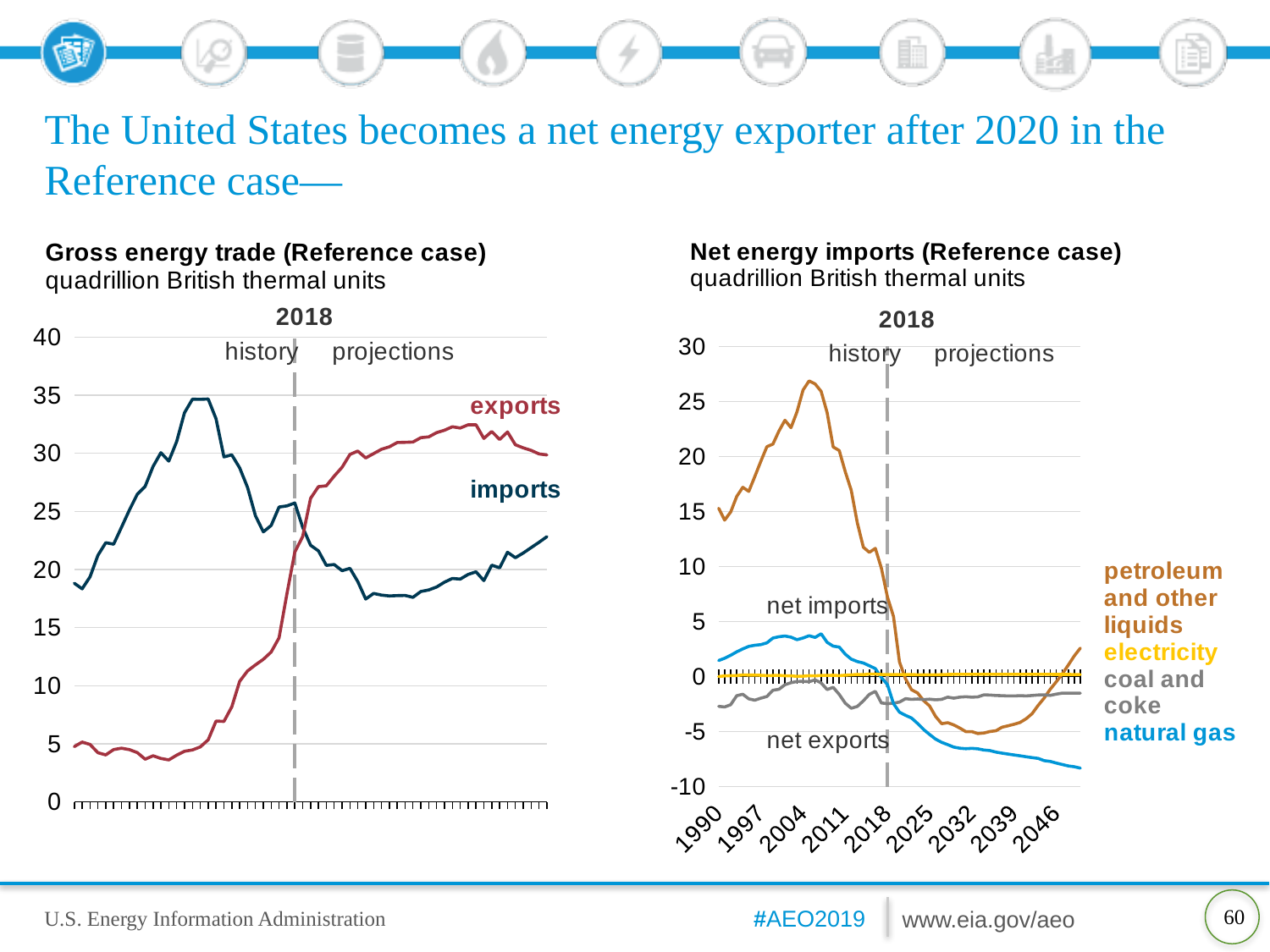
In the 'Gross energy trade (Reference case)' chart, which is larger at the end of the projection period, exports or imports? exports In the 'Net energy imports (Reference case)' chart, is the value for natural gas at the end of the projection period greater or less than -5? less How many series are listed in the legend of the 'Net energy imports (Reference case)' chart? 4 What kind of chart is the 'Gross energy trade (Reference case)' chart on the left? line chart In the 'Gross energy trade (Reference case)' chart, do exports rise or fall between 1990 and 2018? rise What year does the dashed vertical line separating history from projections mark on both charts? 2018 In the 'Gross energy trade (Reference case)' chart, which is larger at the start of the series in 1990, exports or imports? imports How many series are labelled on the 'Gross energy trade (Reference case)' chart? 2 In the 'Net energy imports (Reference case)' chart, does natural gas rise or fall over the projection period after 2018? fall In the 'Gross energy trade (Reference case)' chart, is the peak value of imports greater or less than 30? greater In the 'Gross energy trade (Reference case)' chart, is the value of exports at the start of the series (1990) greater or less than 10? less